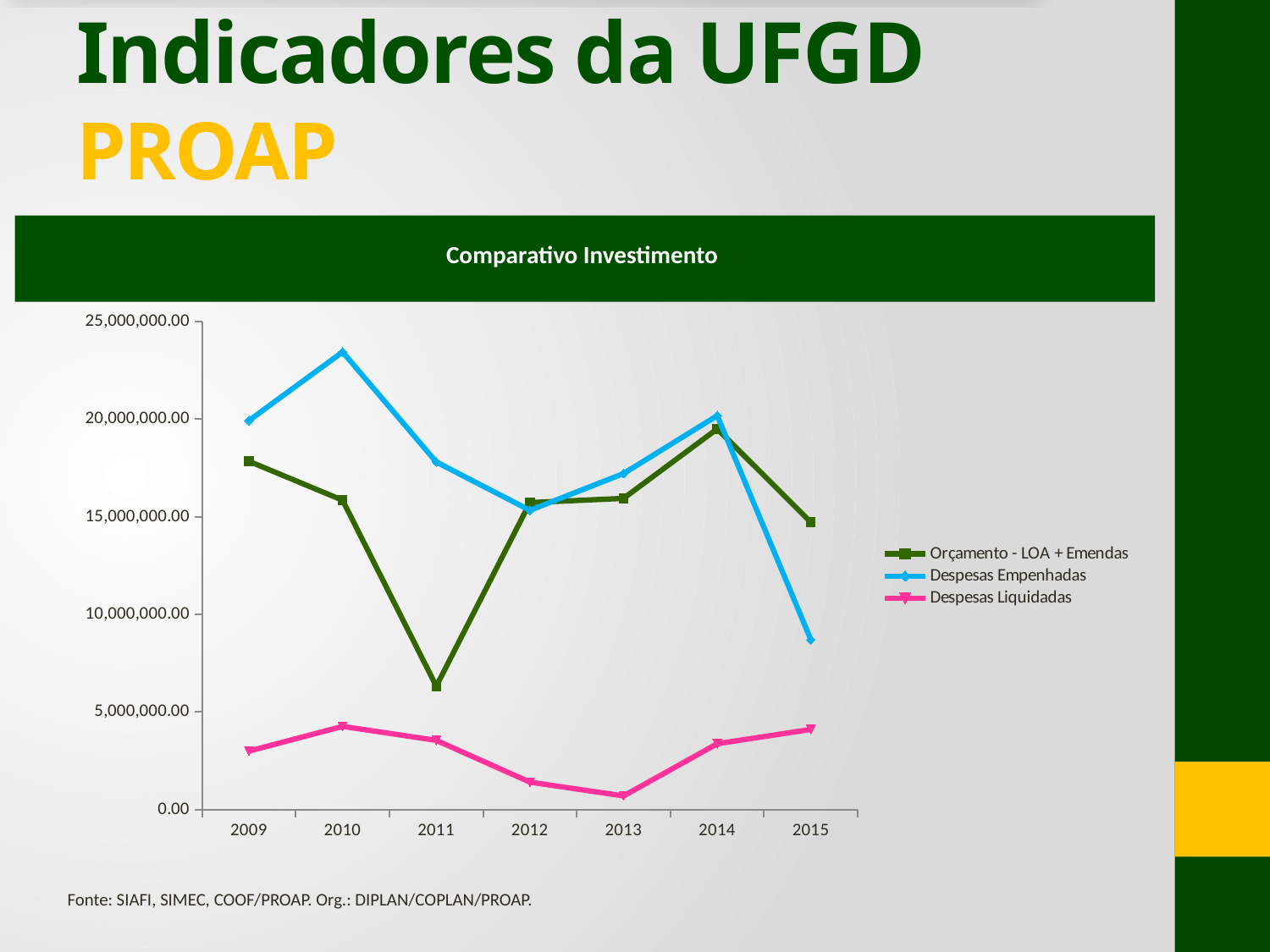
In which year is 'Despesas Liquidadas' lowest? 2013 What is the title of the chart on the slide? Comparativo Investimento How many years are shown on the x axis of the 'Comparativo Investimento' chart? 7 In which year is 'Despesas Empenhadas' highest? 2010 In 2015, which is larger: 'Orçamento - LOA + Emendas' or 'Despesas Empenhadas'? Orçamento - LOA + Emendas Is the value for 'Despesas Liquidadas' in 2010 greater or less than 5,000,000.00? less In which year is 'Orçamento - LOA + Emendas' lowest? 2011 What kind of chart is shown under the title 'Comparativo Investimento'? line chart Is the value for 'Despesas Empenhadas' in 2010 greater or less than 20,000,000.00? greater Is the value for 'Orçamento - LOA + Emendas' in 2011 greater or less than 10,000,000.00? less Does 'Despesas Empenhadas' rise or fall from 2014 to 2015? fall How many series does the legend of the 'Comparativo Investimento' chart list? 3